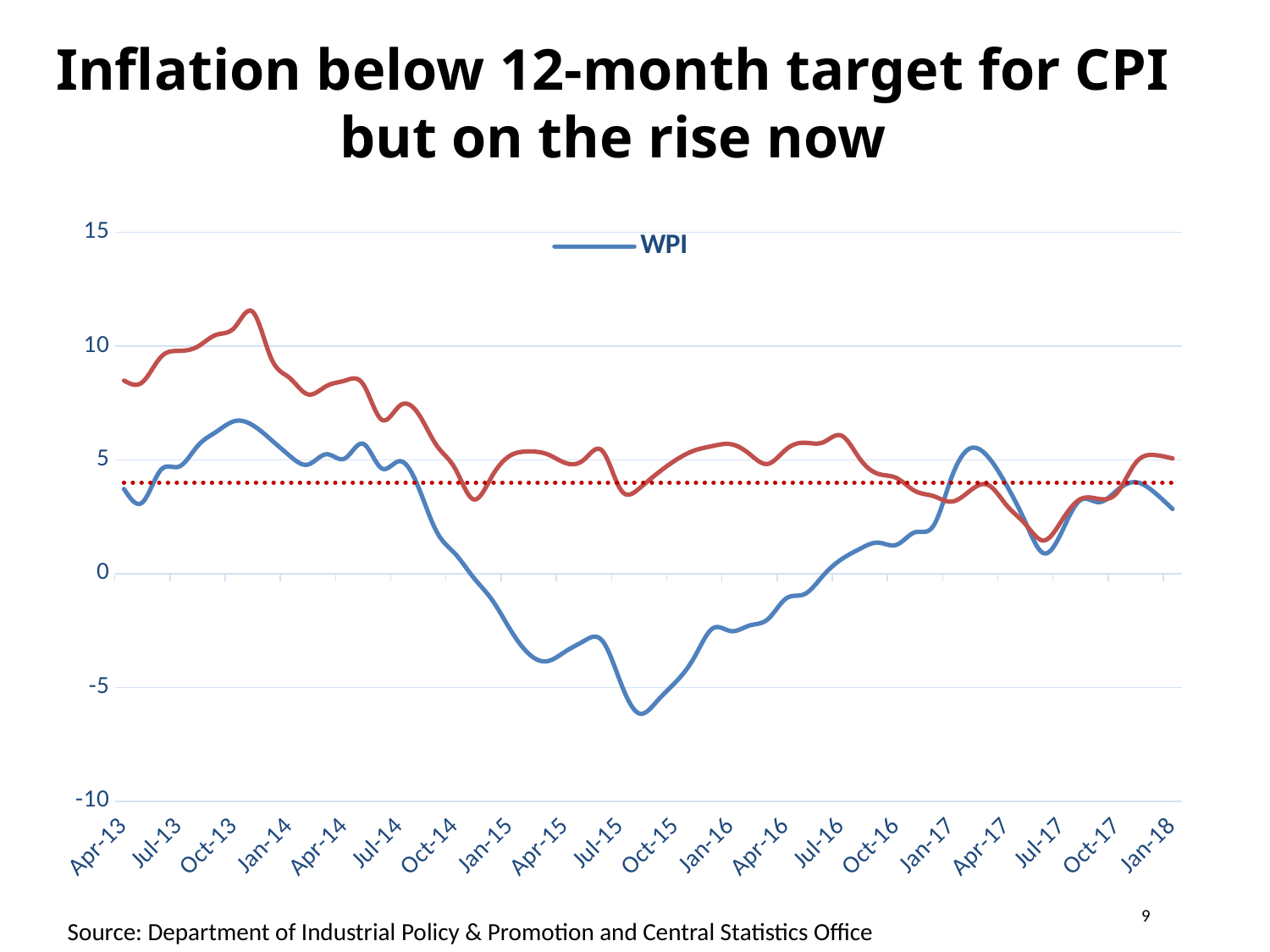
Is the lowest point of the WPI line greater or less than -5? less How many series does the legend list? 1 What series name appears in the legend? WPI What is the first date label on the x axis? Apr-13 Is the WPI value at Jan-18 greater or less than 5? less Is the WPI value at Apr-15 greater or less than 0? less What is the title of the slide? Inflation below 12-month target for CPI but on the rise now What kind of chart is shown on the slide? line chart Does the WPI line rise or fall between Jul-14 and Oct-15? fall Does the WPI line rise or fall between Oct-15 and Jan-17? rise How many date labels are shown on the x axis? 20